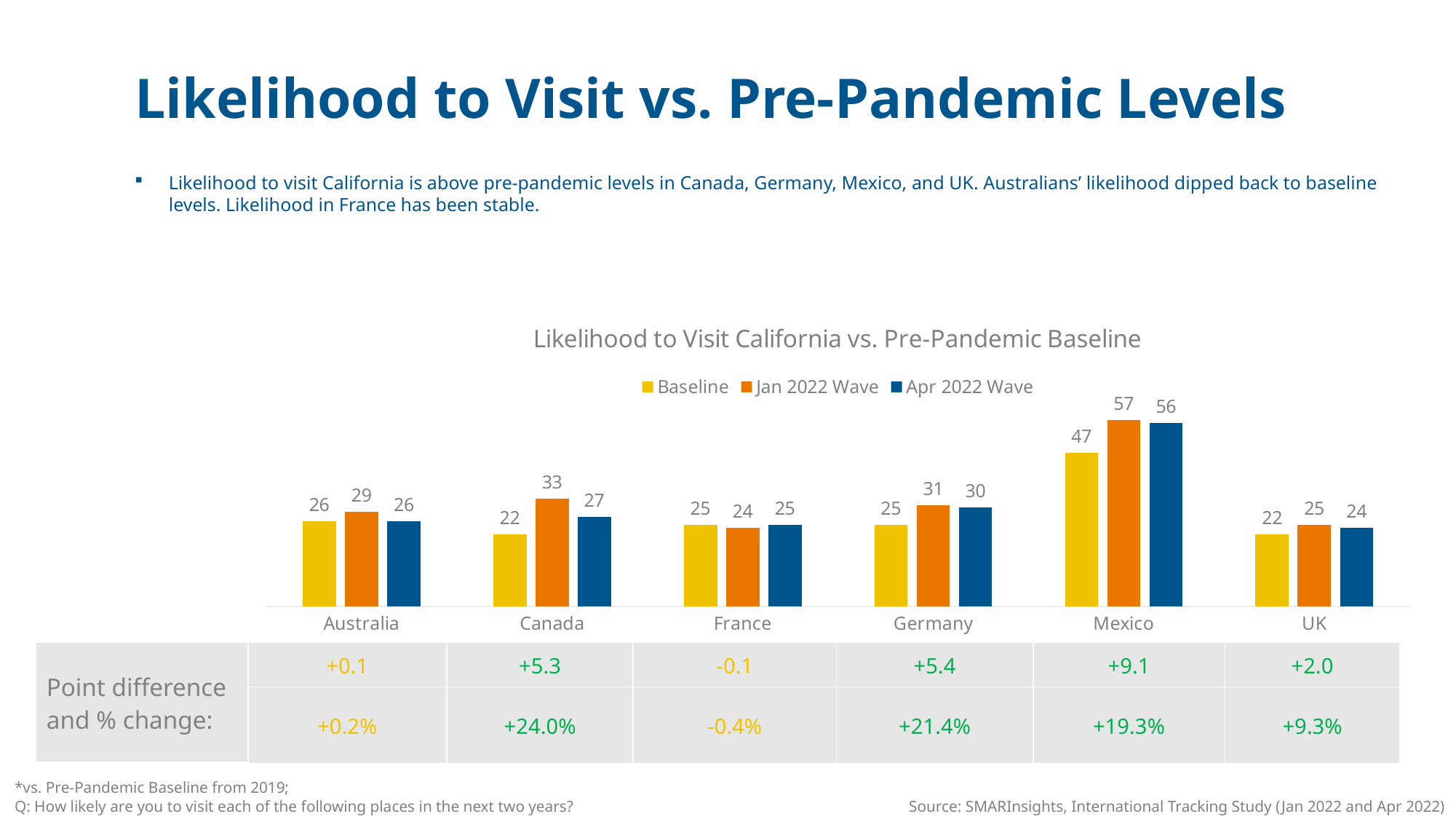
Which series is shown in dark blue? Apr 2022 Wave Which country has the lowest Jan 2022 Wave value? France What kind of chart is shown? Bar chart Is the Apr 2022 Wave value larger for Germany or for the UK? Germany What is the Baseline value for Mexico? 47 What is the Jan 2022 Wave value for Canada? 33 What is the title of the chart? Likelihood to Visit California vs. Pre-Pandemic Baseline What is the Apr 2022 Wave value for Germany? 30 How many series does the legend list? 3 What is the difference between the Jan 2022 Wave and Baseline values for Canada? 11 Which country has the highest Apr 2022 Wave value? Mexico How many countries are shown on the x axis? 6